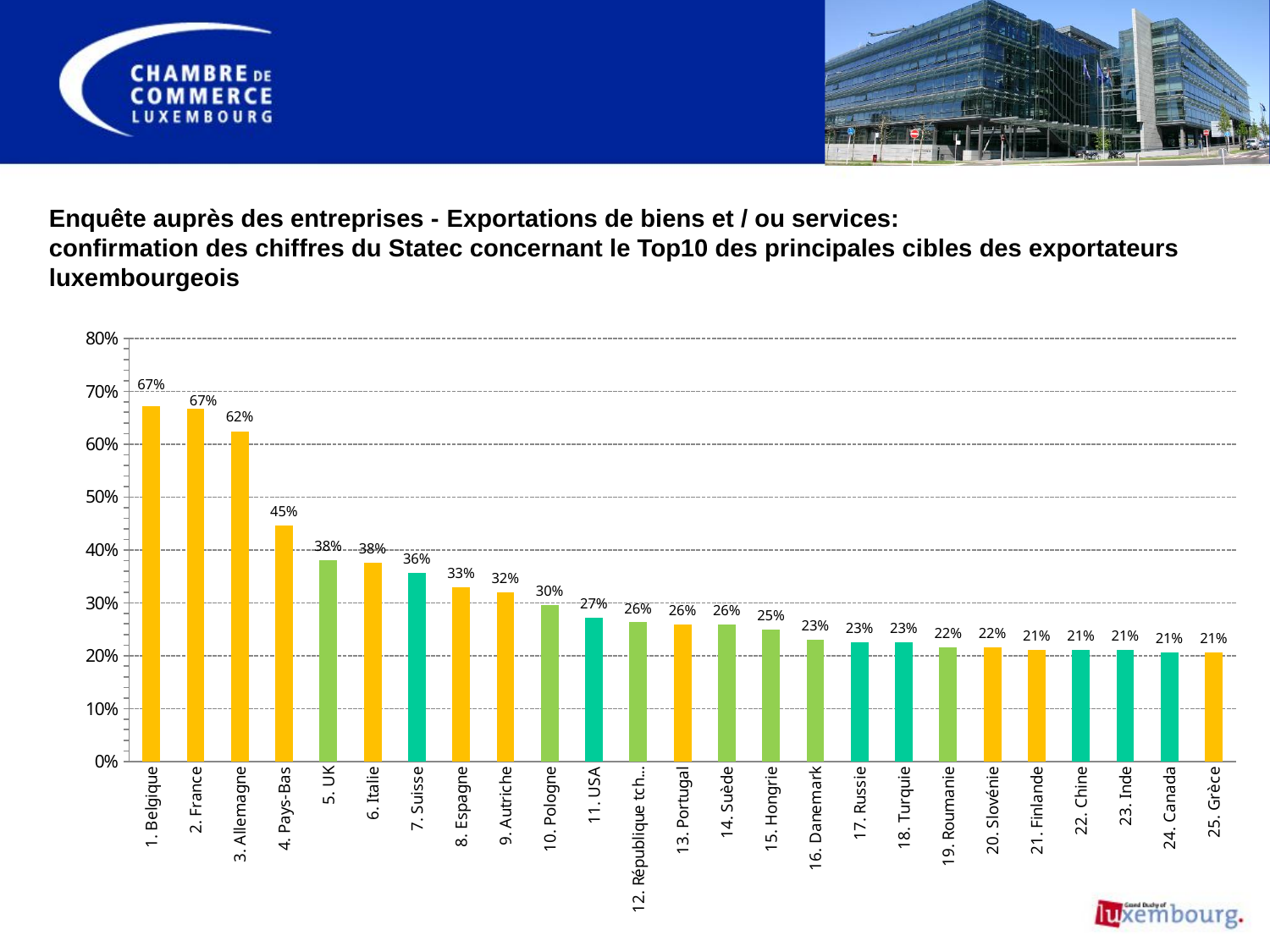
Which has the larger value, 7. Suisse or 8. Espagne? 7. Suisse What is the difference between the values for 1. Belgique and 25. Grèce? 46 percentage points What is the value for 4. Pays-Bas? 45% What is the value for 10. Pologne? 30% Do the values rise or fall from left to right along the x axis? fall What is the value for 11. USA? 27% What is the difference between the values for 3. Allemagne and 4. Pays-Bas? 17 percentage points Is the value for 1. Belgique greater or less than 60%? greater What is the value for 15. Hongrie? 25% What is the value for 3. Allemagne? 62% How many countries are shown on the chart? 25 What kind of chart is shown on the slide? bar chart